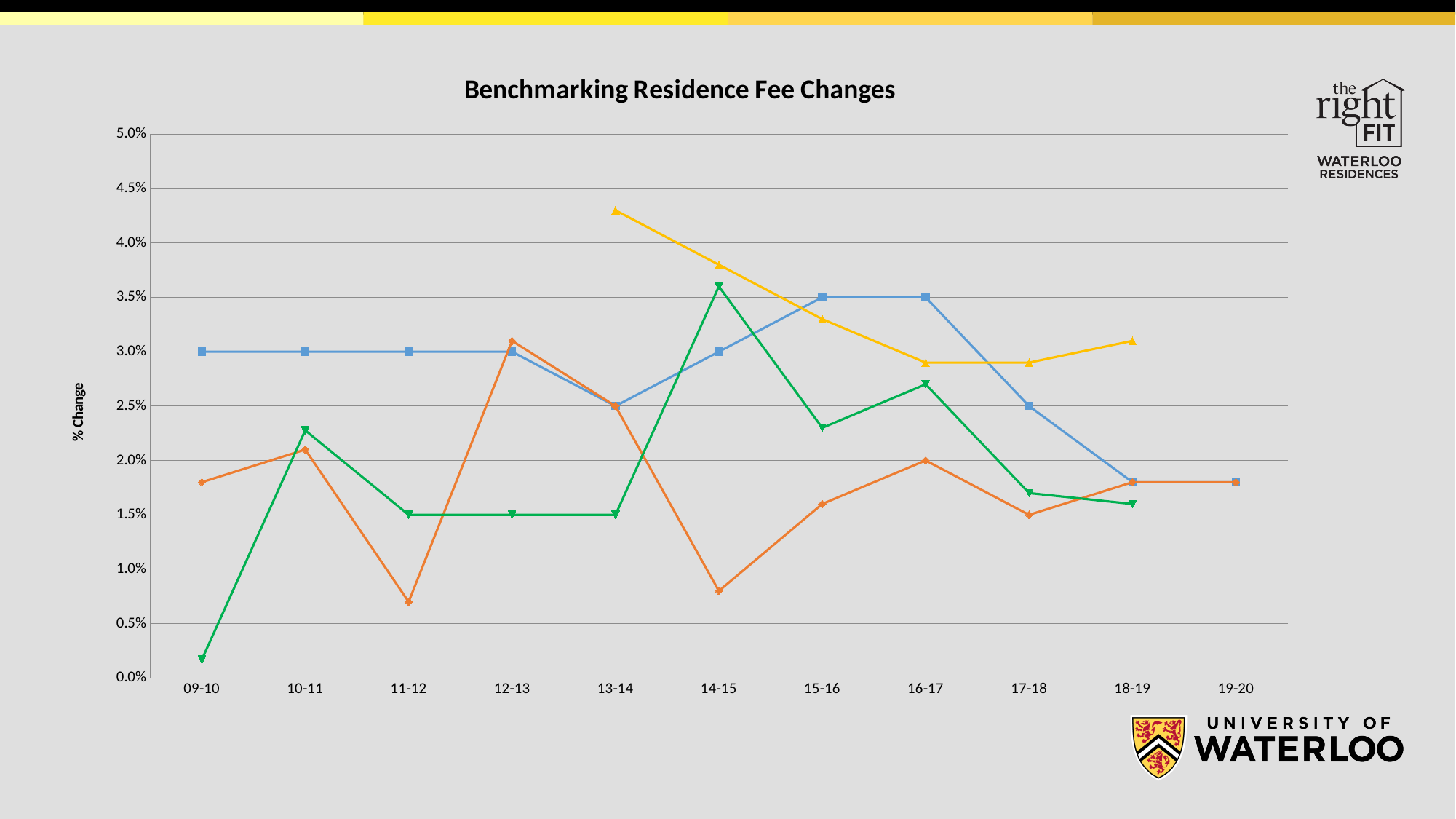
At 14-15, which line has the higher value, the green line or the orange line? green line What is the value of the blue line at 17-18? 2.5% How many academic-year categories are shown on the x axis? 11 What is the difference between the blue line's value at 15-16 and its value at 17-18? 1.0% Is the value of the yellow line at 13-14 greater or less than 4.0%? greater What is the value of the orange line at 16-17? 2.0% What is the label on the vertical axis of the chart? % Change What type of chart is shown on the slide? line chart What is the value of the green line at 11-12? 1.5% Is the value of the green line at 09-10 greater or less than 0.5%? less What is the title of the chart? Benchmarking Residence Fee Changes What is the value of the blue line at 15-16? 3.5%